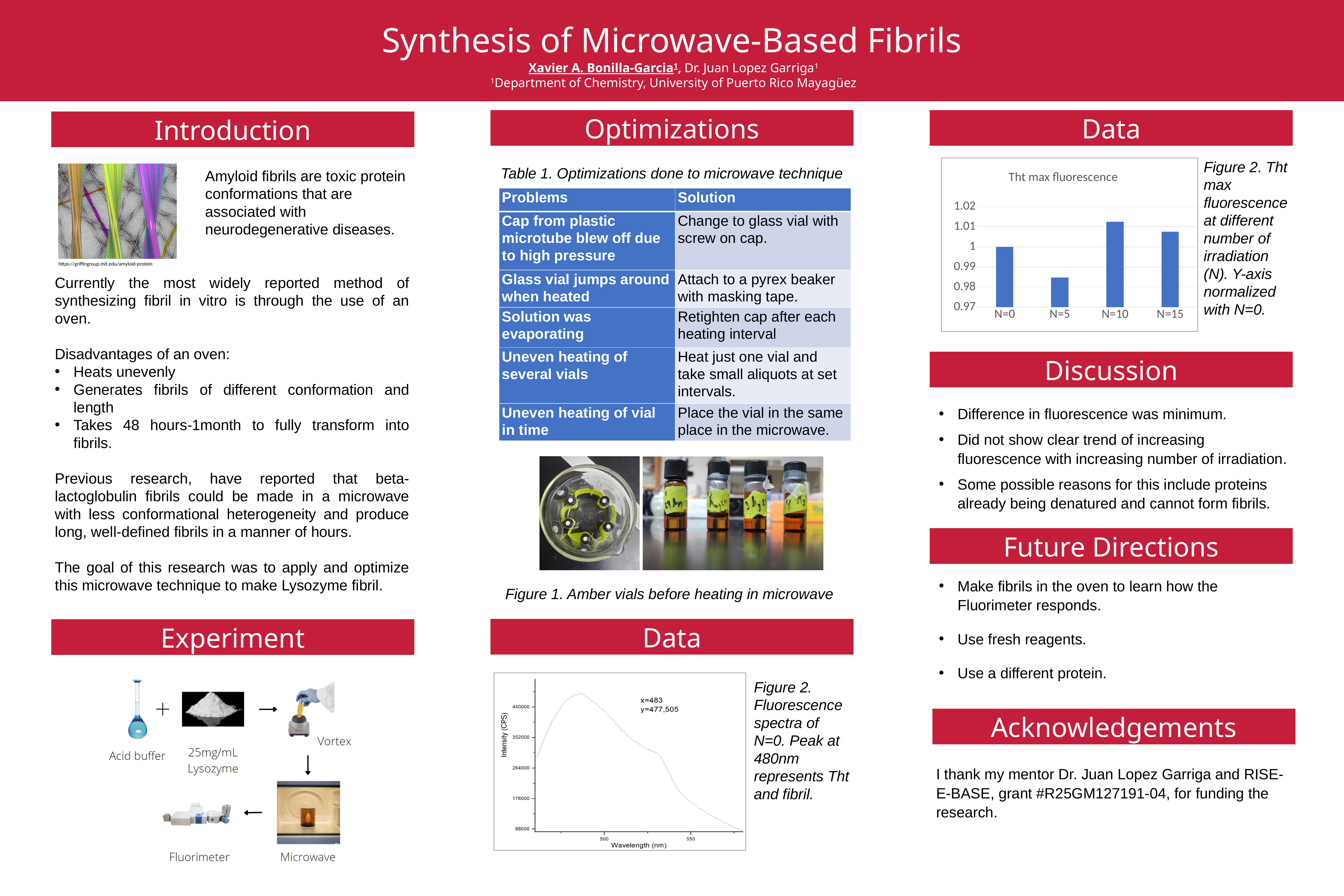
In the 'Tht max fluorescence' chart, what is the value for N=0? 1 In the 'Tht max fluorescence' chart, which is larger, the value for N=5 or the value for N=15? N=15 In the fluorescence spectra chart at the bottom centre, what is the y value of the annotated peak? 477,505 In the fluorescence spectra chart at the bottom centre, what kind of chart is shown? line chart In the 'Tht max fluorescence' chart, which category has the lowest value? N=5 In the 'Tht max fluorescence' chart, which category has the highest value? N=10 In the 'Tht max fluorescence' chart, is the value for N=10 greater or less than 1.01? greater In the 'Tht max fluorescence' chart, is the value for N=15 greater or less than 1? greater In the 'Tht max fluorescence' chart, how many categories are plotted? 4 In the 'Tht max fluorescence' chart, what kind of chart is shown? bar chart In the 'Tht max fluorescence' chart, what is the lowest value shown on the y axis? 0.97 In the 'Tht max fluorescence' chart, is the value for N=5 greater or less than 0.99? less